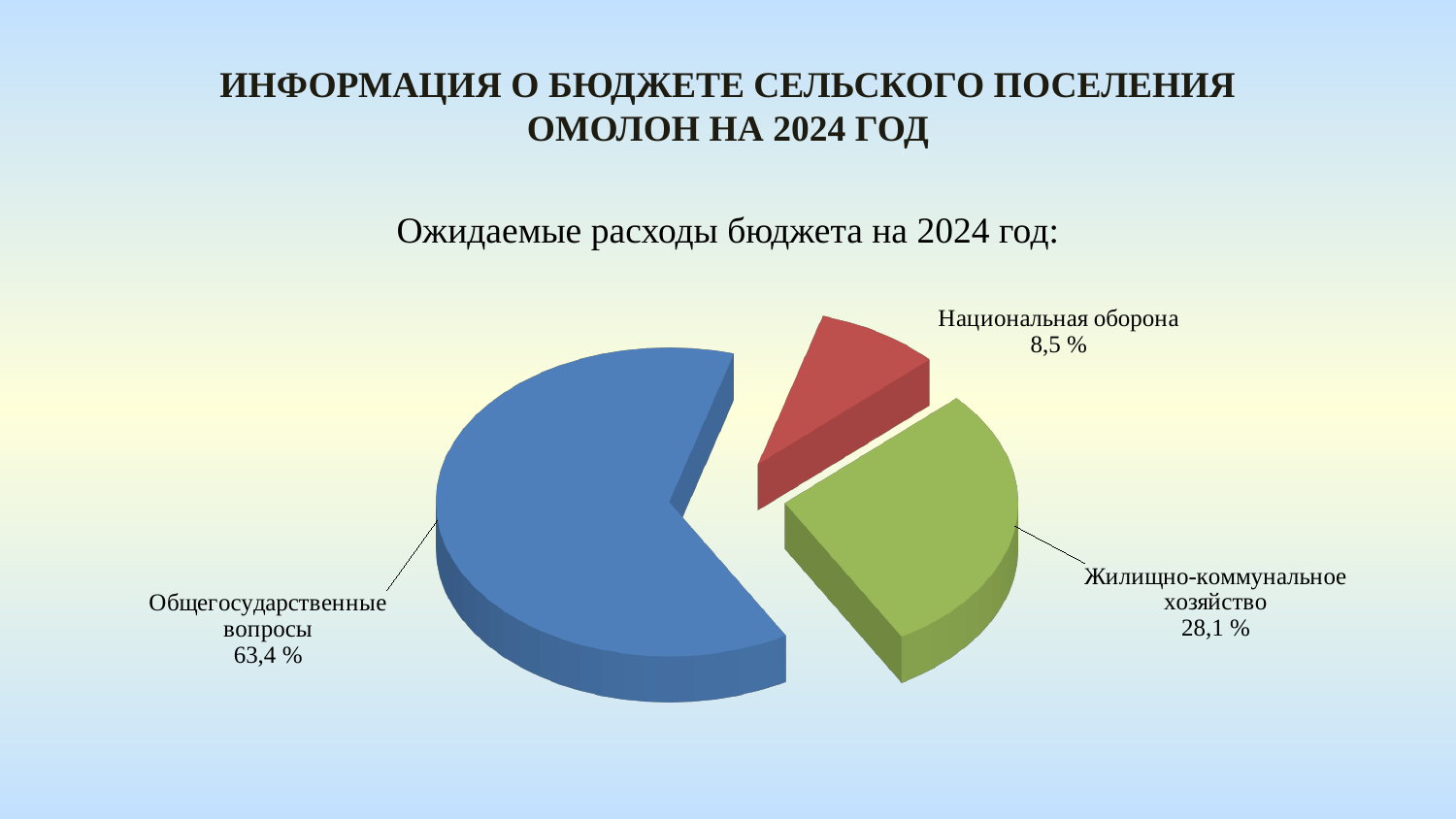
By how many percentage points does the share of Общегосударственные вопросы exceed that of Жилищно-коммунальное хозяйство? 35,3 By how many percentage points does the share of Жилищно-коммунальное хозяйство exceed that of Национальная оборона? 19,6 What type of chart is used to show the expected 2024 budget expenditures? Pie chart How many expenditure categories are shown in the pie chart? 3 Which expenditure category has the smallest share of the pie? Национальная оборона What is the subtitle above the chart? Ожидаемые расходы бюджета на 2024 год: What share of expected 2024 budget expenditures goes to Национальная оборона? 8,5 % Which expenditure category has the largest share of the pie? Общегосударственные вопросы What share of expected 2024 budget expenditures goes to Жилищно-коммунальное хозяйство? 28,1 % Which is larger: the share for Жилищно-коммунальное хозяйство or the share for Национальная оборона? Жилищно-коммунальное хозяйство What colour is the slice representing Национальная оборона? Red What share of expected 2024 budget expenditures goes to Общегосударственные вопросы? 63,4 %